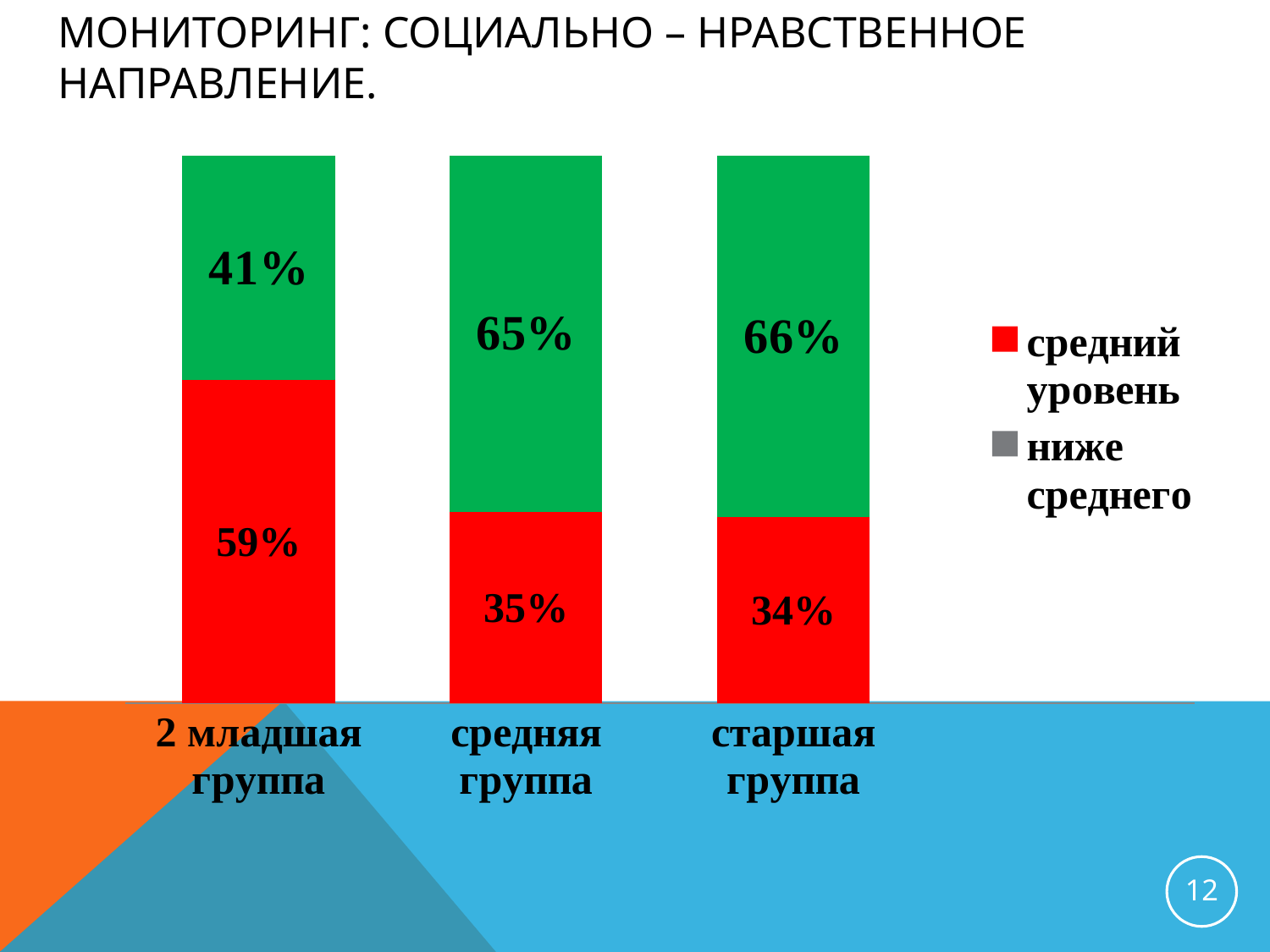
How many groups are shown on the x axis? 3 What is the value of the средний уровень segment for средняя группа? 35% What kind of chart is shown on the slide? stacked bar chart What is the value of the средний уровень segment for старшая группа? 34% Which group has the highest средний уровень value? 2 младшая группа What is the value of the средний уровень segment for 2 младшая группа? 59% Which group has the lowest средний уровень value? старшая группа Is the green (top) segment larger for средняя группа or старшая группа? старшая группа What is the difference between the средний уровень values for 2 младшая группа and средняя группа? 24% What is the value of the green (top) segment for старшая группа? 66% How many series does the legend list? 2 What is the value of the green (top) segment for 2 младшая группа? 41%